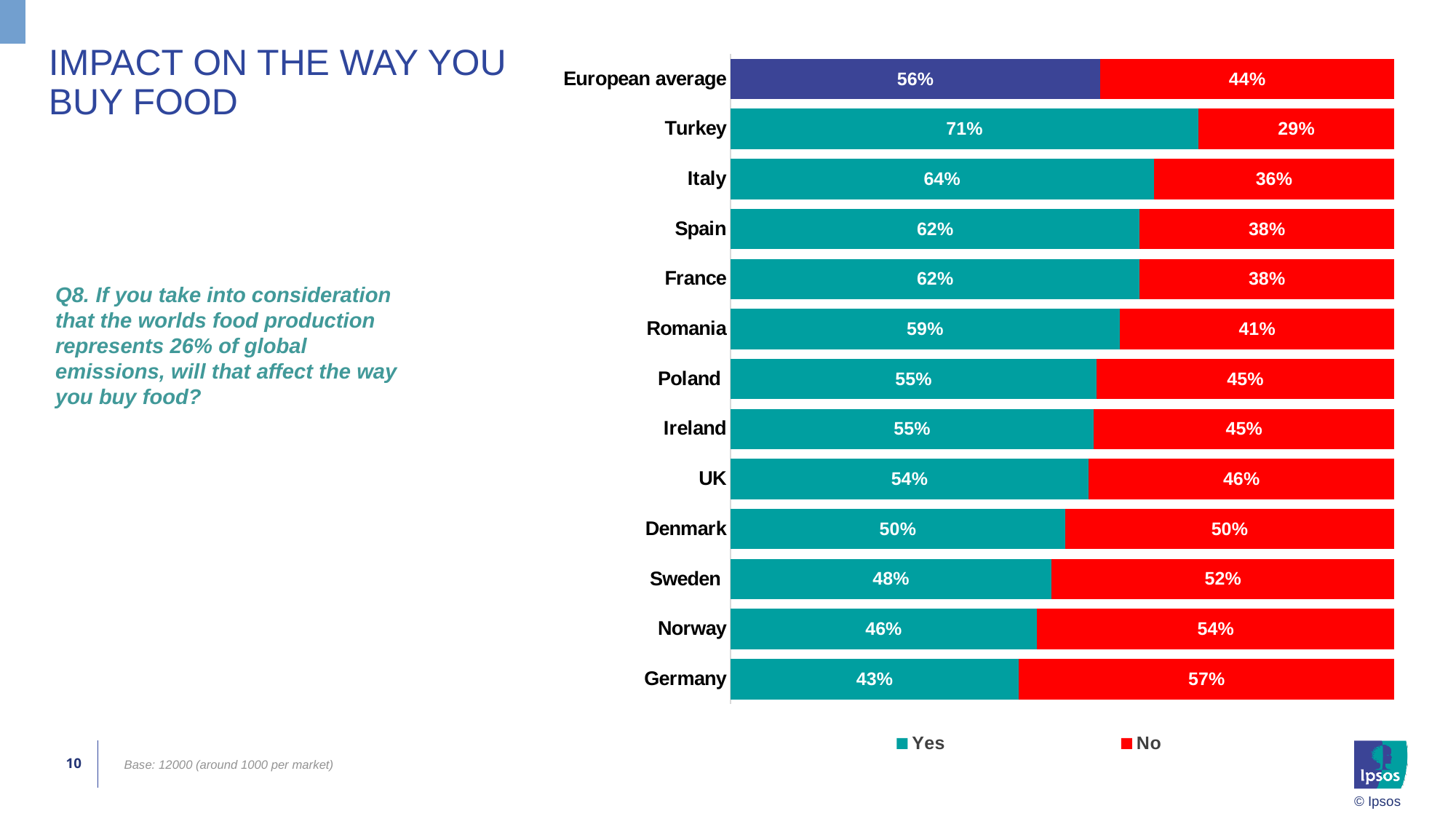
Which country has the highest Yes percentage? Turkey What is the No value for Germany? 57% What type of chart is shown on the slide? Stacked bar chart What percentage of respondents in Turkey answered Yes? 71% What is the Yes value for the European average? 56% How many series does the legend list? 2 Which country has the lowest Yes percentage? Germany What is the difference between the Yes values for Italy and Sweden? 16 percentage points What is the total of the Yes and No values for Denmark? 100% Which has a higher Yes value, Romania or Norway? Romania What colour represents the No series in the chart? Red How many countries (excluding the European average) are shown in the chart? 12